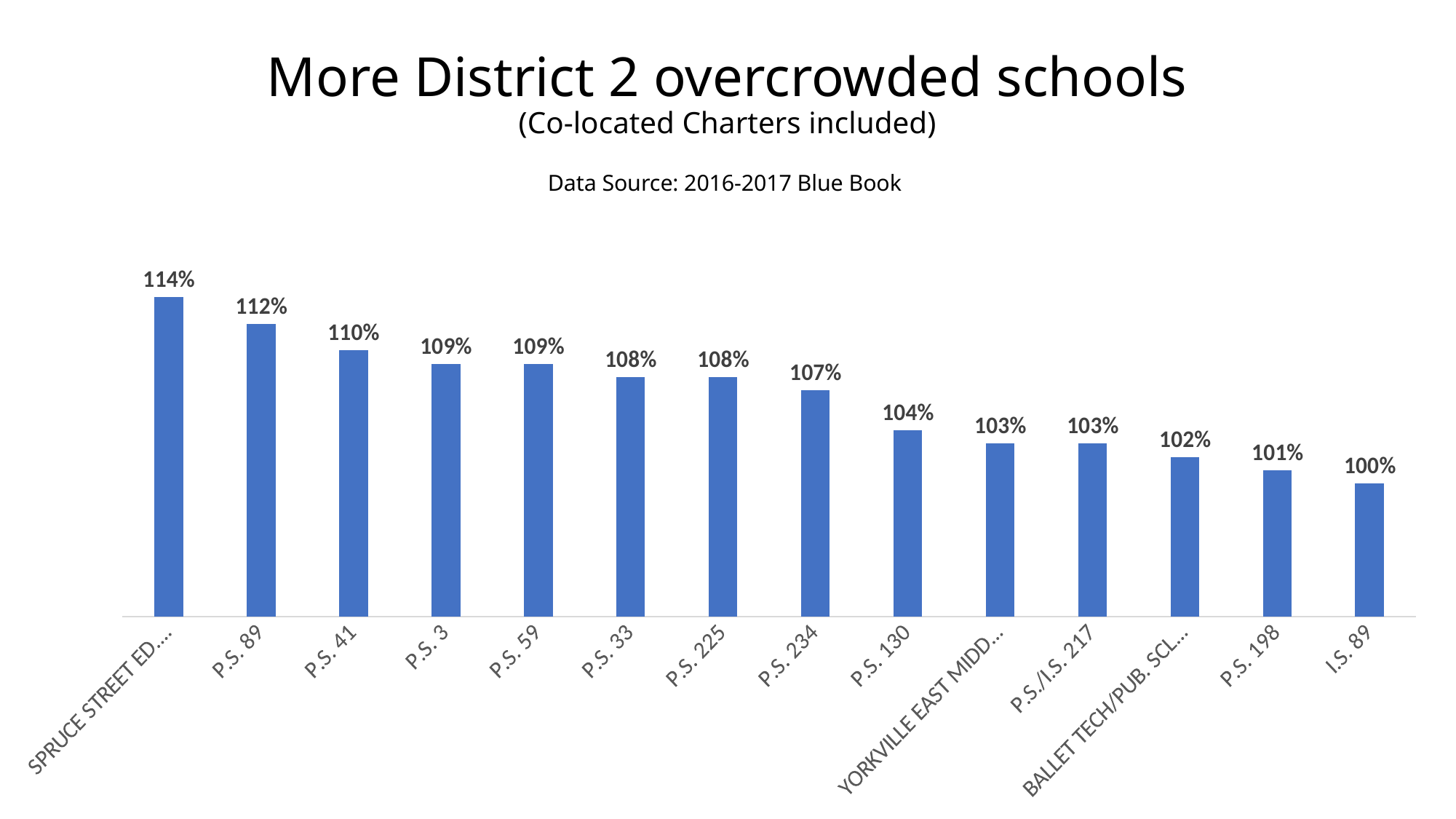
Which school has the lowest value? I.S. 89 What is the value for P.S. 130? 104% What is the value for P.S. 41? 110% What data source is cited on the slide? 2016-2017 Blue Book Which is larger, the value for P.S. 234 or the value for P.S. 130? P.S. 234 What is the value for P.S. 89? 112% What is the value for P.S./I.S. 217? 103% What kind of chart is shown on the slide? Bar chart What is the difference between the values for P.S. 89 and P.S. 198? 11% How many schools are shown in the chart? 14 What is the value for I.S. 89? 100% Do the values rise or fall from left to right along the x axis? Fall